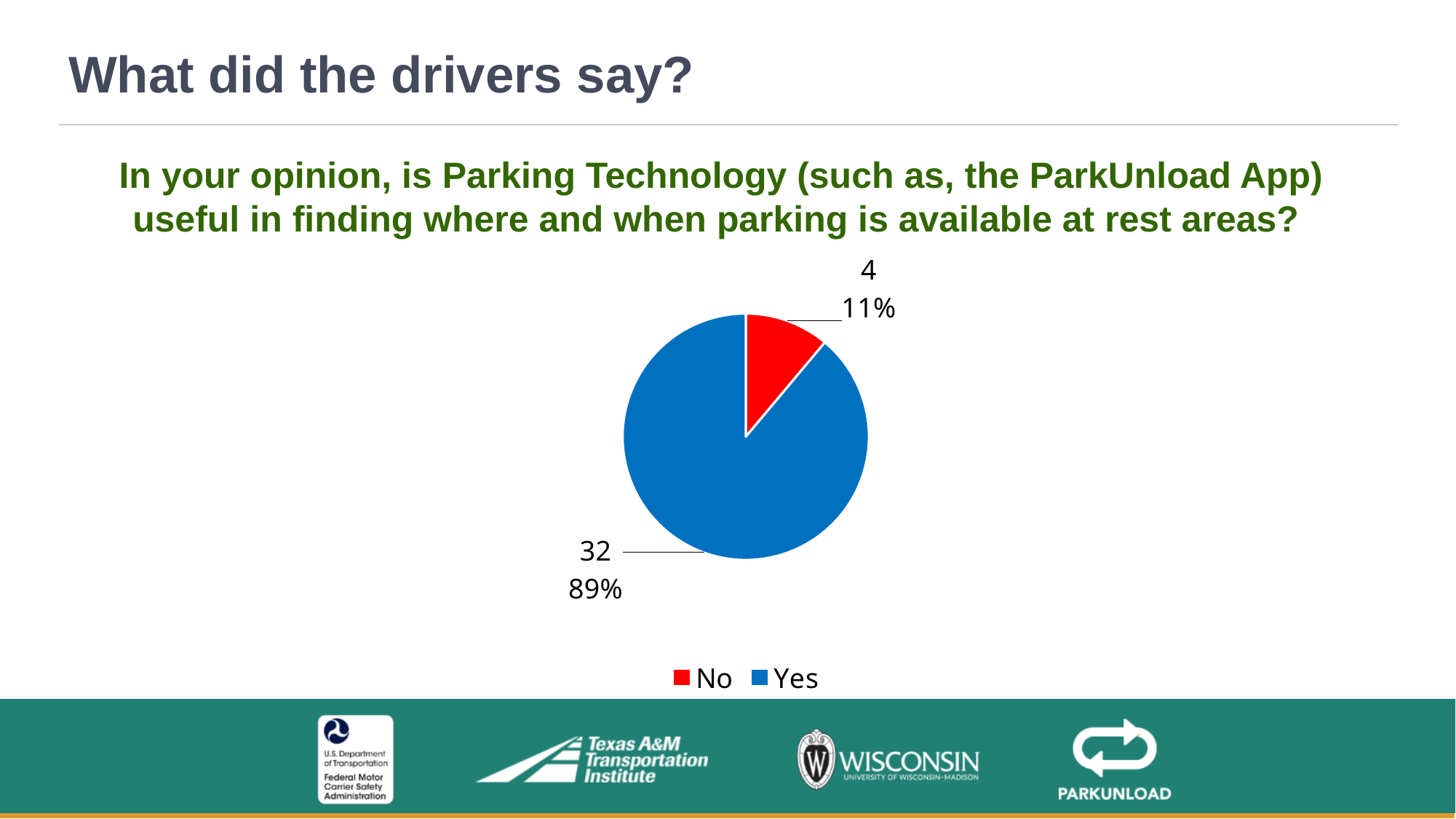
What percentage of respondents answered No? 11% How many more respondents answered Yes than No? 28 How many respondents answered No? 4 What percentage of respondents answered Yes? 89% Which colour represents the Yes responses? blue Which response has the smallest slice of the pie? No What is the total number of respondents shown in the pie chart? 36 What kind of chart is shown on the slide? pie chart Which response has the largest slice of the pie? Yes How many categories does the legend list? 2 Which colour represents the No responses? red How many respondents answered Yes? 32